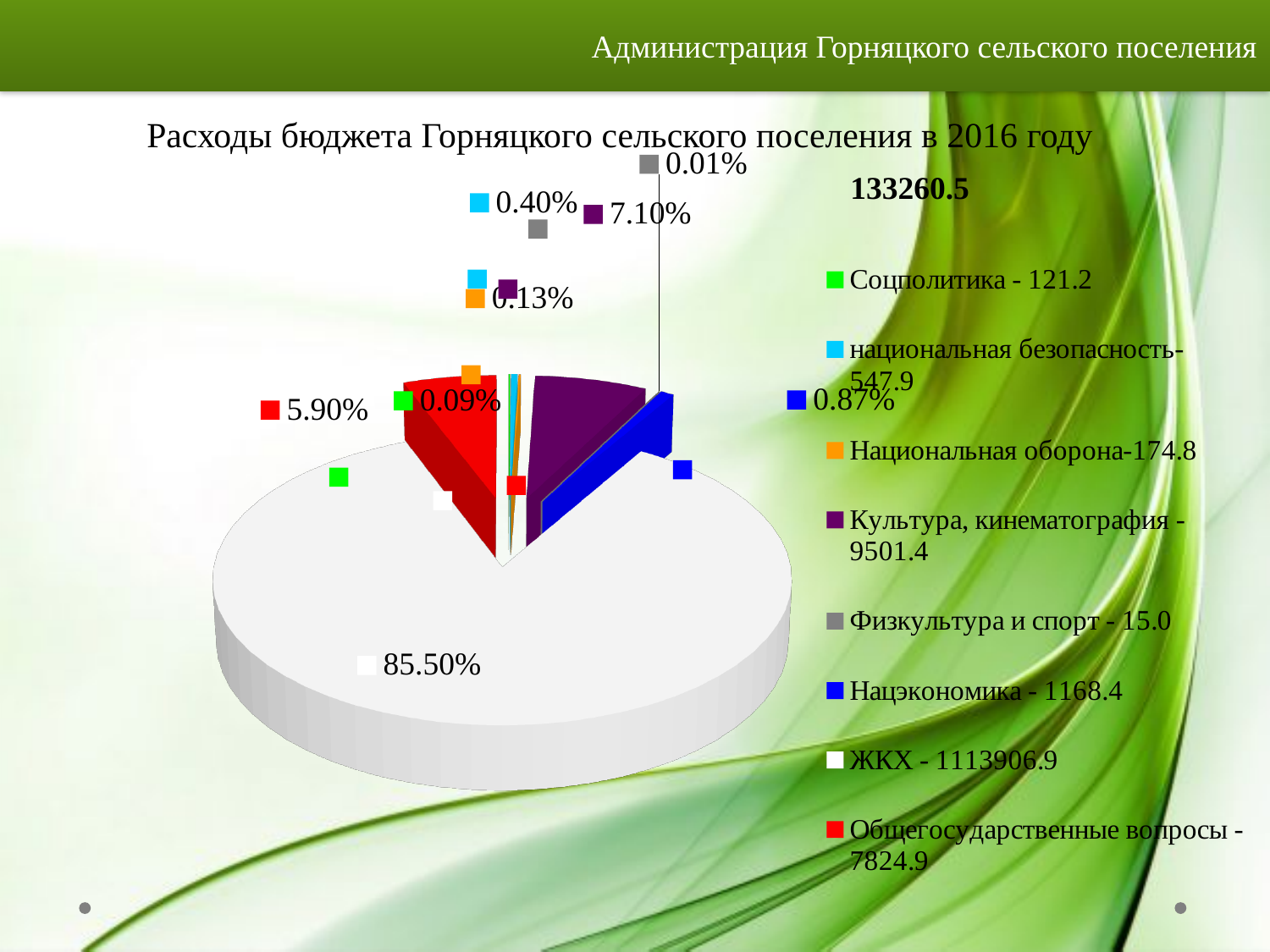
What value does the legend give for Культура, кинематография? 9501.4 What is the title of the chart? Расходы бюджета Горняцкого сельского поселения в 2016 году What percentage share is shown for the purple slice (Культура, кинематография)? 7.10% What percentage share is shown for the white slice (ЖКХ)? 85.50% What kind of chart is shown on the slide? pie chart Which slice is larger: the cyan slice (национальная безопасность) or the orange slice (Национальная оборона)? cyan (национальная безопасность) Which category has the largest share of the pie chart? ЖКХ What percentage share is shown for the blue slice (Нацэкономика)? 0.87% How many categories does the legend of the pie chart list? 8 Which category has the smallest share of the pie chart? Физкультура и спорт What percentage share is shown for the red slice (Общегосударственные вопросы)? 5.90% What is the difference in percentage points between the purple slice (7.10%) and the red slice (5.90%)? 1.20%